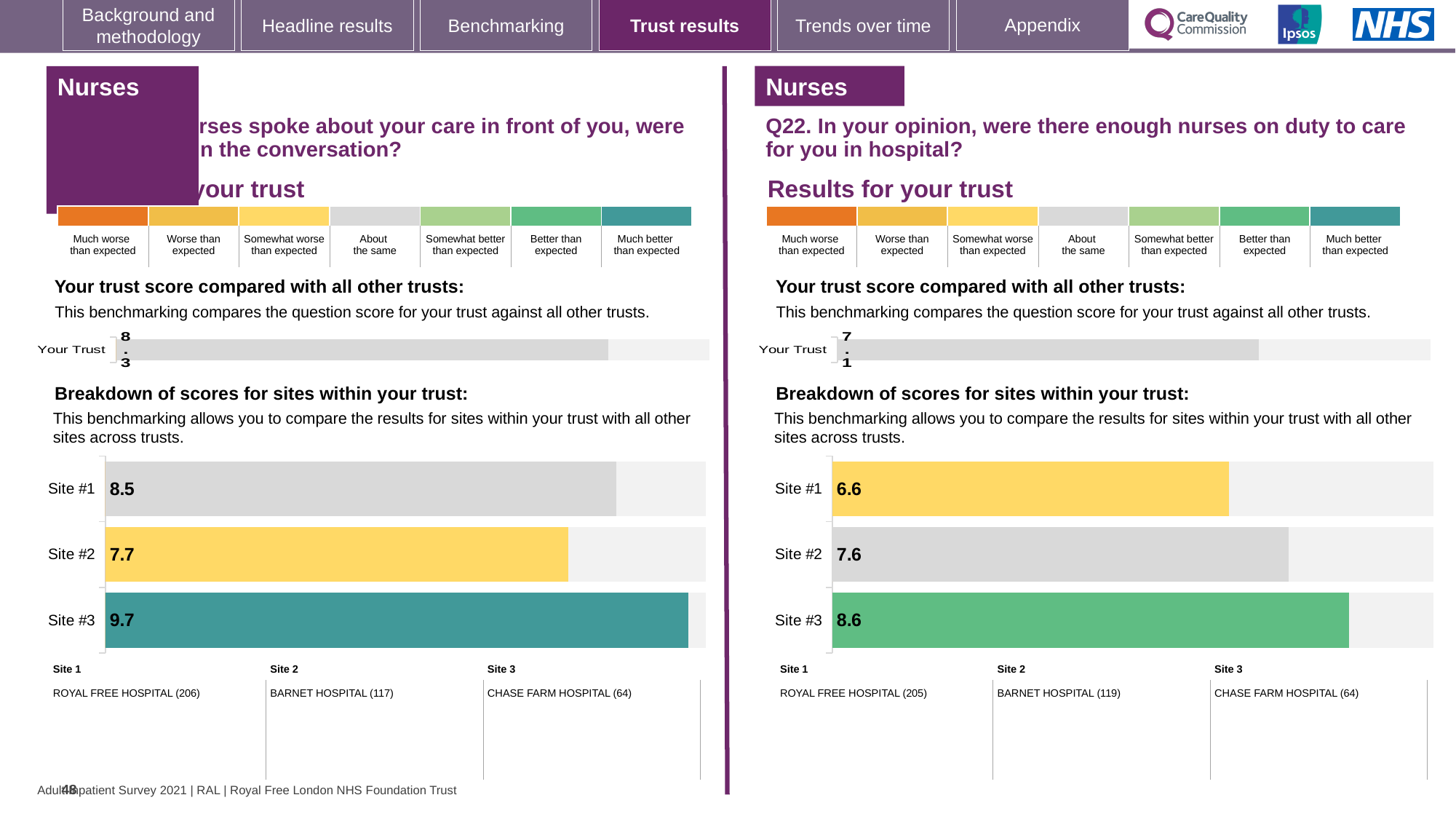
On the left-hand site breakdown chart, which site has the highest score? Site #3 How many sites are shown on the left-hand site breakdown chart? 3 On the right-hand (Q22) 'Your trust score compared with all other trusts' chart, what is the score for Your Trust? 7.1 On the left-hand site breakdown chart, what is the score for Site #2? 7.7 On the right-hand (Q22) site breakdown chart, what is the score for Site #3? 8.6 On the left-hand site breakdown chart, what is the score for Site #3? 9.7 On the right-hand (Q22) site breakdown chart, which site has the lowest score? Site #1 On the left-hand 'Your trust score compared with all other trusts' chart, what is the score for Your Trust? 8.3 On the right-hand (Q22) site breakdown chart, which has the larger score, Site #2 or Site #1? Site #2 On the left-hand site breakdown chart, what is the difference between the scores for Site #3 and Site #2? 2.0 On the right-hand (Q22) site breakdown chart, what is the score for Site #1? 6.6 On the right-hand (Q22) site breakdown chart, what is the difference between the scores for Site #3 and Site #1? 2.0